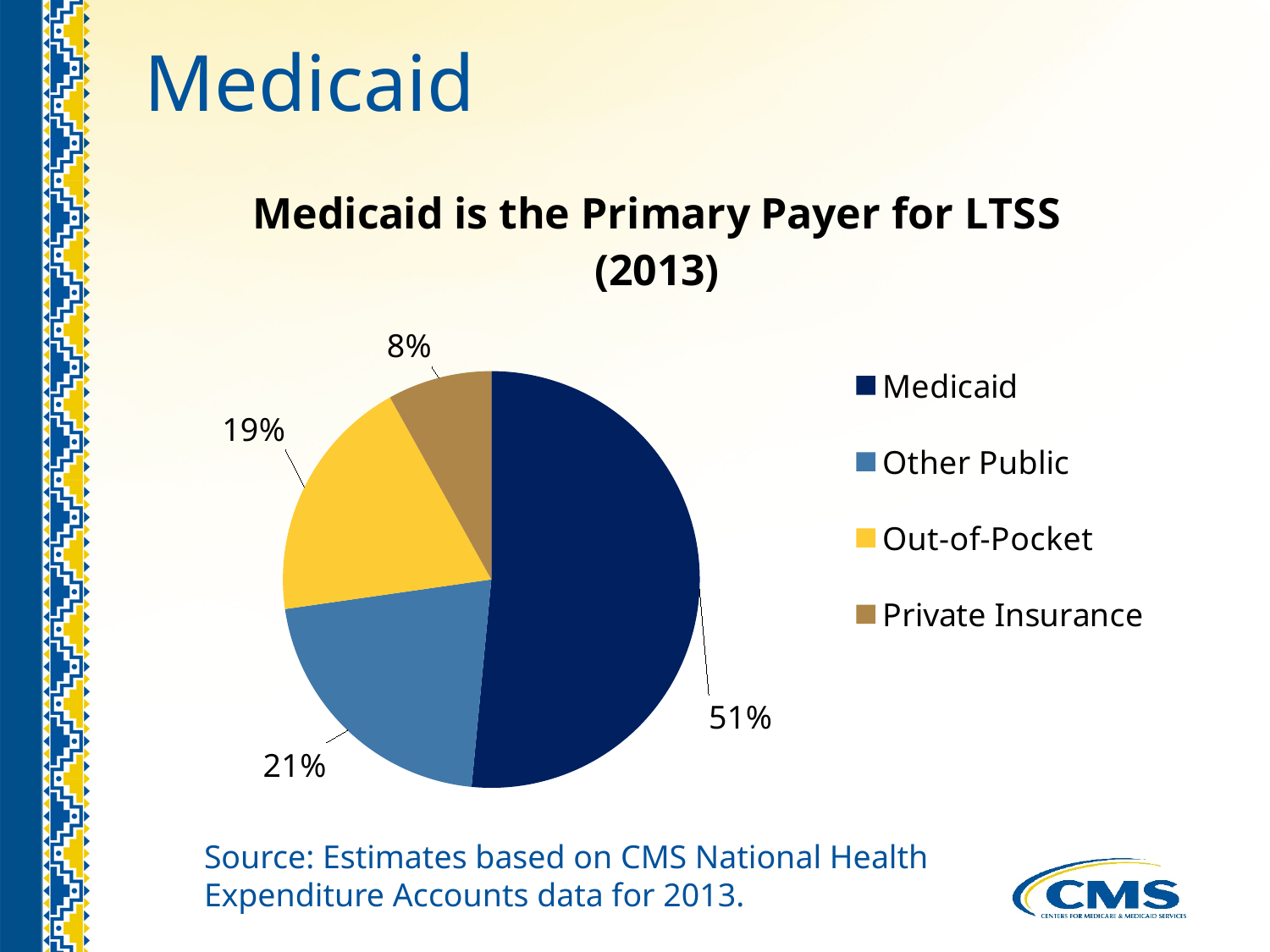
What is the difference in percentage points between the Out-of-Pocket slice and the Private Insurance slice? 11 Which payer has the smallest slice of the pie chart? Private Insurance Which payer has the largest slice of the pie chart? Medicaid Which is larger, the Other Public slice or the Out-of-Pocket slice? Other Public How many payer categories are shown in the pie chart? 4 What percentage is shown for Private Insurance in the pie chart? 8% What is the title of the chart? Medicaid is the Primary Payer for LTSS (2013) What percentage is shown for Out-of-Pocket in the pie chart? 19% What is the difference in percentage points between the Medicaid slice and the Other Public slice? 30 What type of chart is shown on the slide? Pie chart What percentage is shown for Other Public in the pie chart? 21% What share of LTSS spending does Medicaid account for in the pie chart? 51%